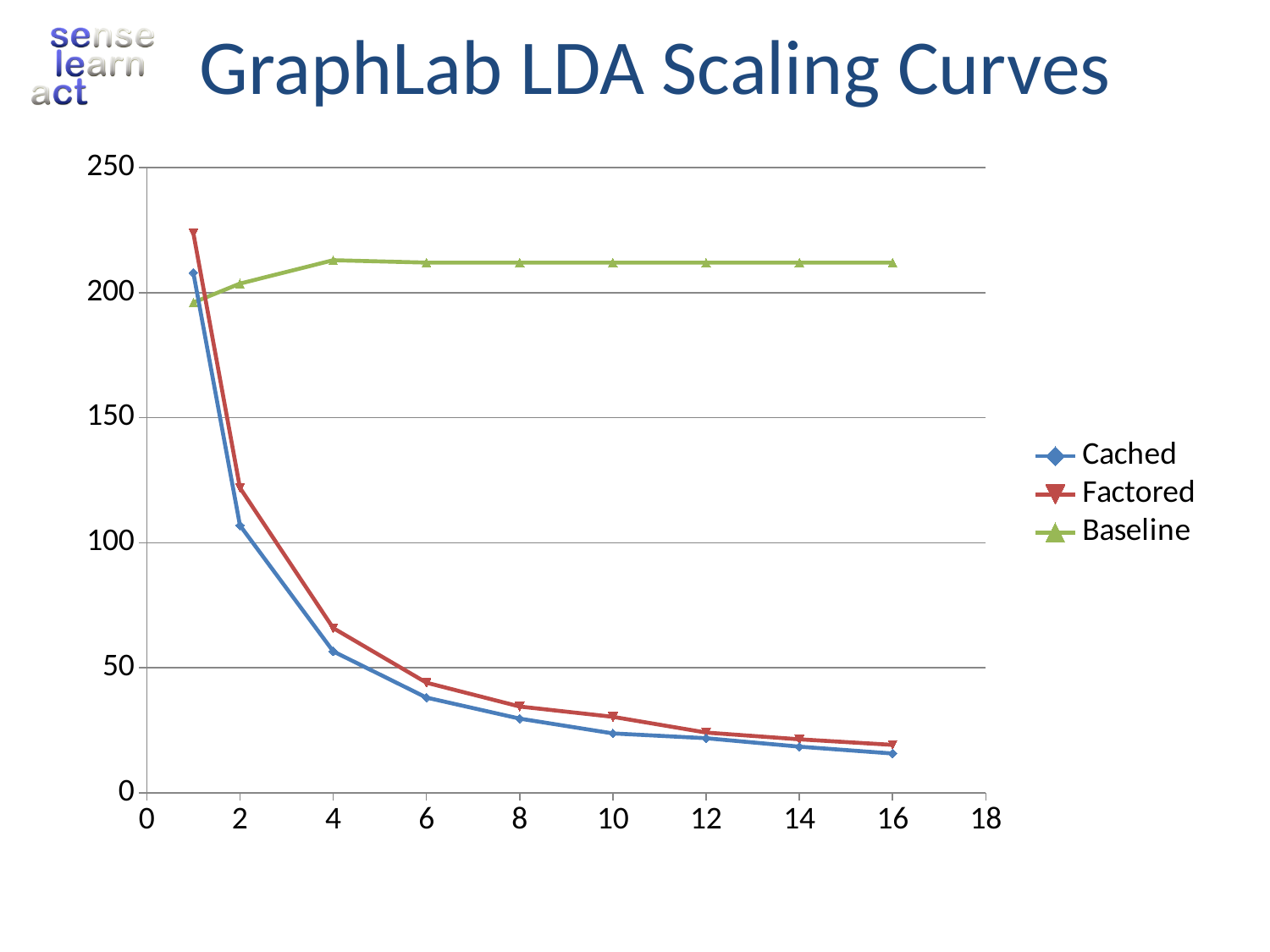
Is the value for Factored at x = 1 greater or less than 200? greater Is the value for Cached at x = 16 greater or less than 50? less Which series has the highest value at x = 16? Baseline What kind of chart is shown on the slide? line chart Is the value for Cached at x = 2 greater or less than 100? greater How many data points are plotted for the Cached series? 9 What is the title of the chart? GraphLab LDA Scaling Curves Do the values of the Cached series rise or fall as the x axis increases? fall Which series is drawn in green? Baseline At x = 4, which series has the larger value, Cached or Factored? Factored How many series does the legend list? 3